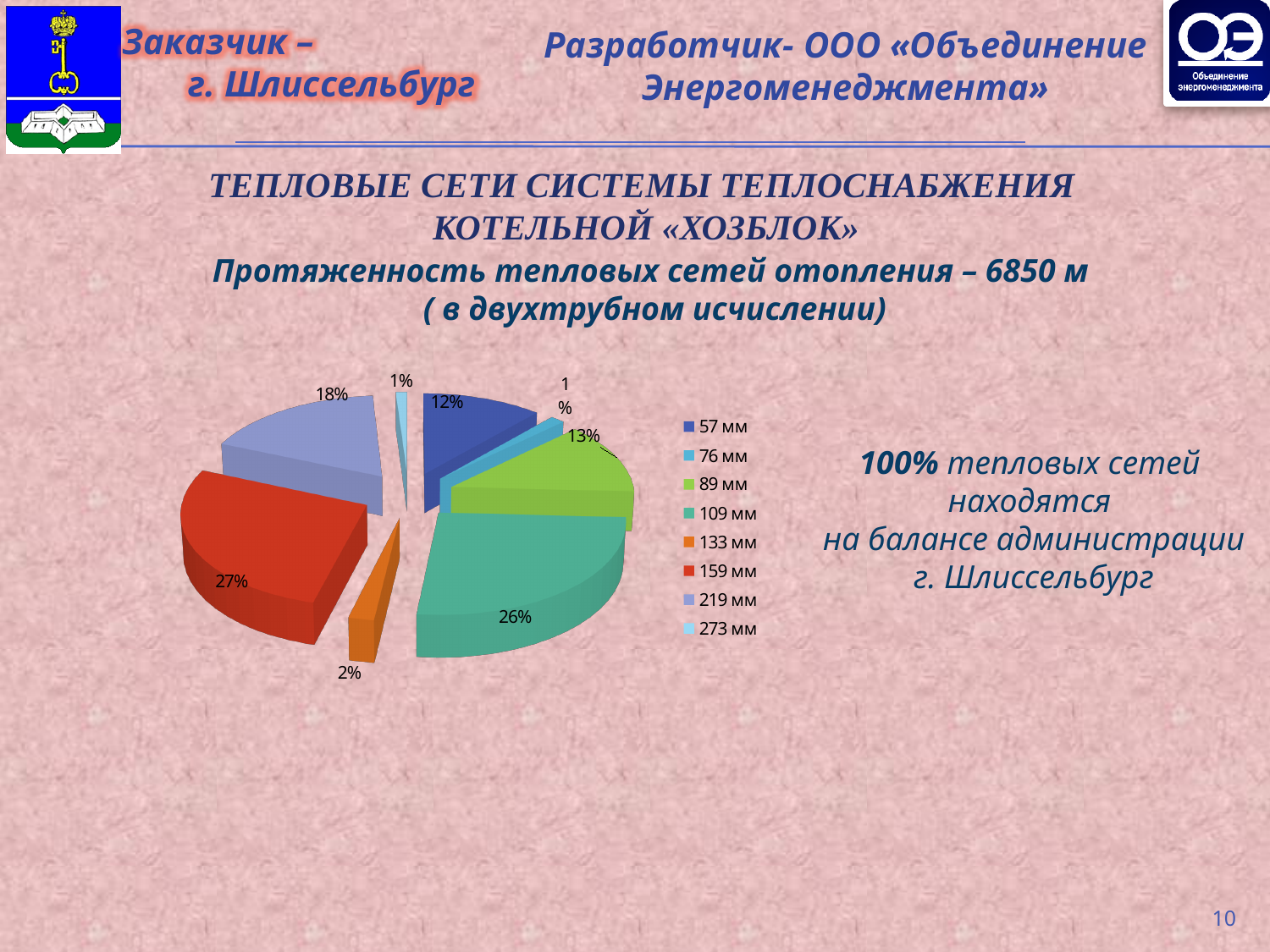
What share of the pie does the 109 мм slice represent? 26% What total length of heating networks is stated above the chart? 6850 м How many categories does the legend of the pie chart list? 8 What colour is the 109 мм slice in the pie chart? teal (green-blue) What share of the pie does the 57 мм slice represent? 12% Which slice is larger, 219 мм or 89 мм? 219 мм What share of the pie does the 133 мм slice represent? 2% What type of chart is shown on the slide? pie chart What is the difference in percentage points between the 159 мм slice and the 89 мм slice? 14 Which category has the largest share of the pie? 159 мм